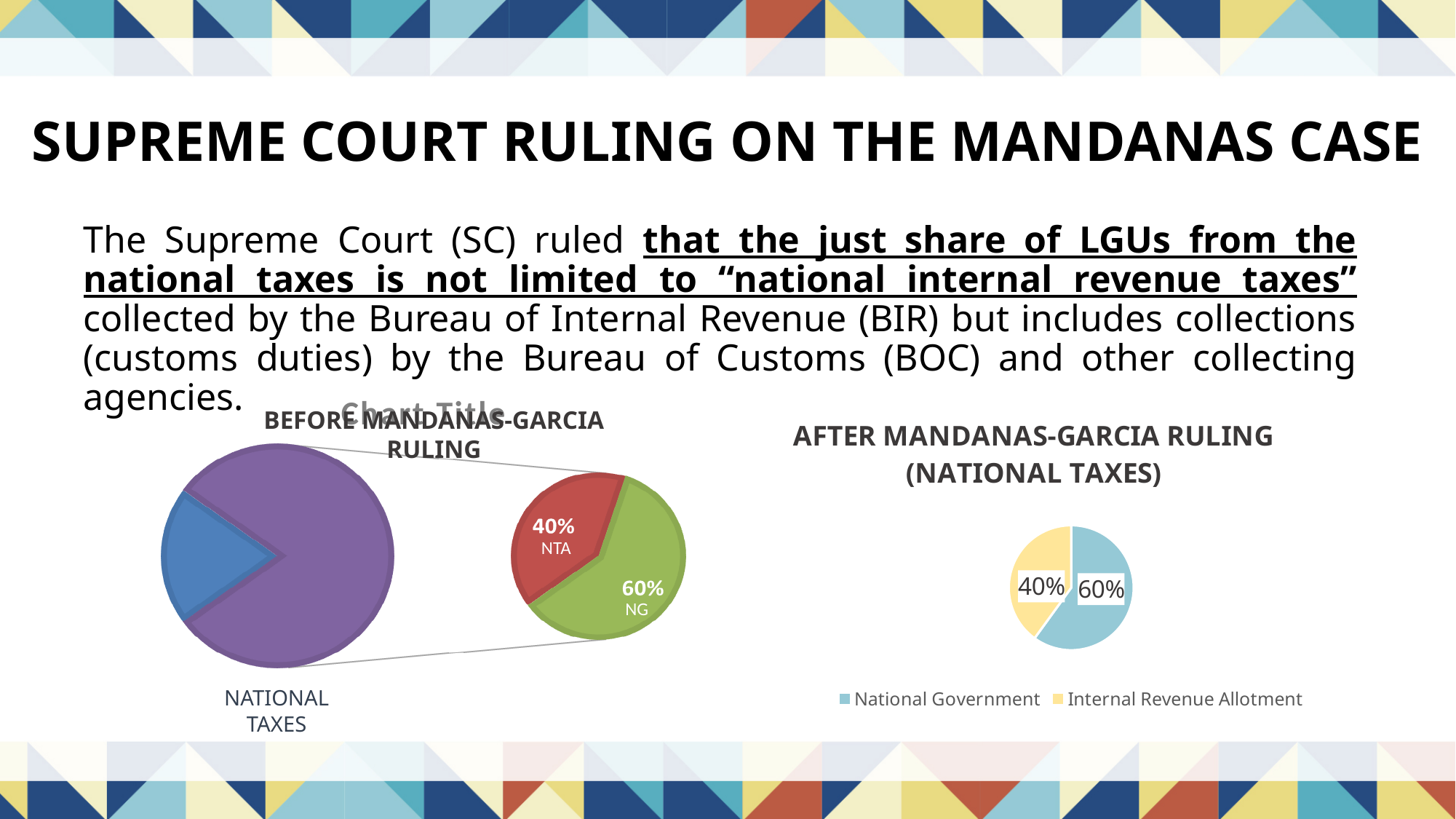
How many entries does the legend of the 'AFTER MANDANAS-GARCIA RULING (NATIONAL TAXES)' chart list? 2 In the 'AFTER MANDANAS-GARCIA RULING (NATIONAL TAXES)' chart, what share does Internal Revenue Allotment have? 40% In the 'BEFORE MANDANAS-GARCIA RULING' chart, which slice of the smaller pie is larger, NTA or NG? NG In the 'AFTER MANDANAS-GARCIA RULING (NATIONAL TAXES)' chart, what colour is the Internal Revenue Allotment slice? Yellow In the 'BEFORE MANDANAS-GARCIA RULING' chart, what is the difference between the NG share and the NTA share? 20% In the 'BEFORE MANDANAS-GARCIA RULING' chart, what share is labelled NTA? 40% In the 'AFTER MANDANAS-GARCIA RULING (NATIONAL TAXES)' chart, which slice is larger, National Government or Internal Revenue Allotment? National Government What is the category label shown below the large pie in the 'BEFORE MANDANAS-GARCIA RULING' chart? NATIONAL TAXES What kind of chart is the 'AFTER MANDANAS-GARCIA RULING (NATIONAL TAXES)' chart? Pie chart In the 'AFTER MANDANAS-GARCIA RULING (NATIONAL TAXES)' chart, what is the difference between the National Government share and the Internal Revenue Allotment share? 20% In the 'AFTER MANDANAS-GARCIA RULING (NATIONAL TAXES)' chart, what share does National Government have? 60% In the 'BEFORE MANDANAS-GARCIA RULING' chart, what share is labelled NG? 60%